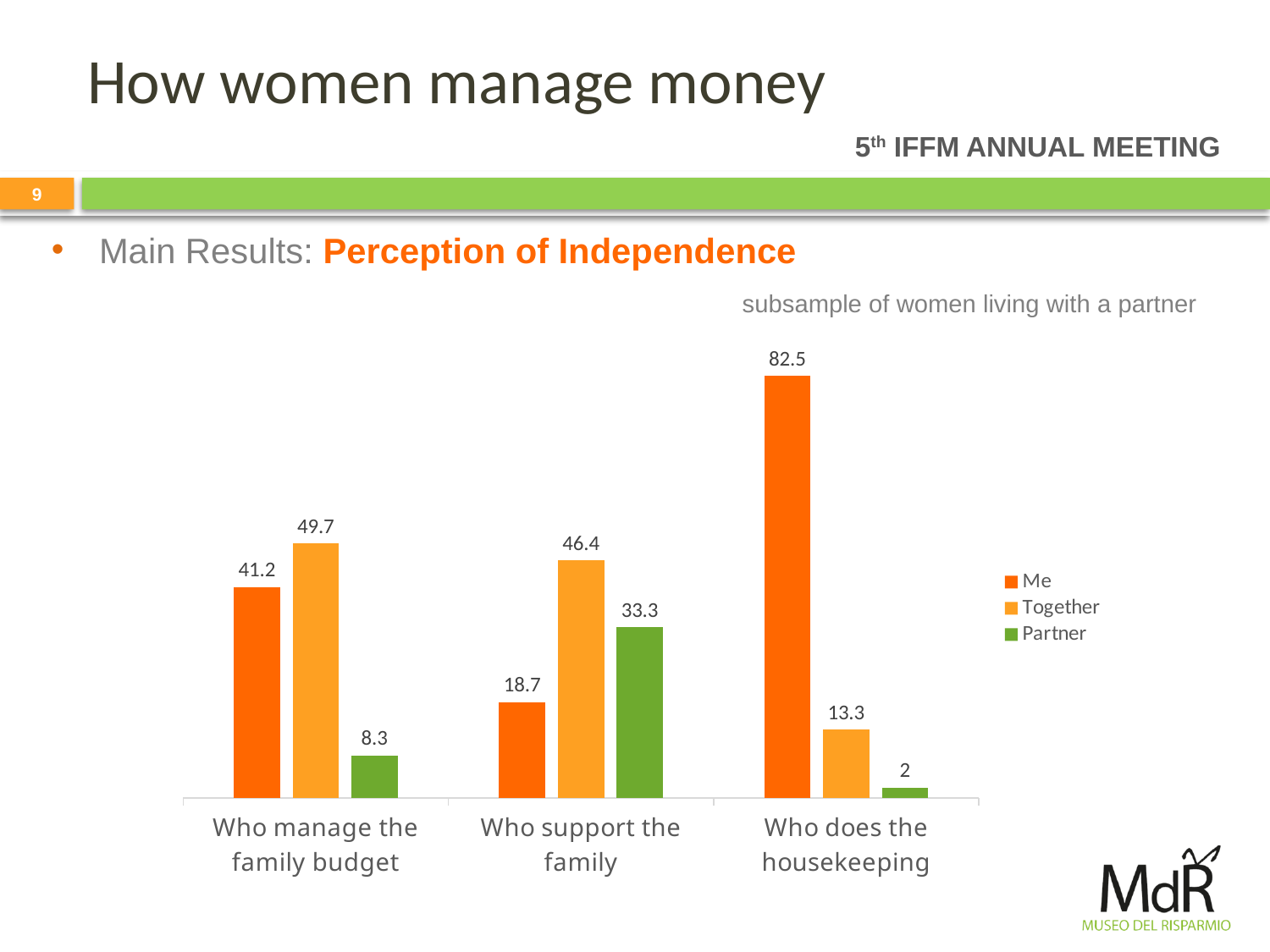
What is the value for "Partner" in the "Who support the family" category? 33.3 Which series has the lowest value in the "Who does the housekeeping" category? Partner Which colour represents the "Partner" series in the legend? Green What is the difference between the "Me" and "Partner" values in the "Who does the housekeeping" category? 80.5 How many categories are shown on the x axis? 3 Which is larger: the "Me" value for "Who manage the family budget" or the "Me" value for "Who support the family"? Who manage the family budget What is the difference between the "Together" and "Me" values in the "Who support the family" category? 27.7 What is the value for "Together" in the "Who manage the family budget" category? 49.7 What kind of chart is shown on the slide? Bar chart What is the value for "Me" in the "Who does the housekeeping" category? 82.5 Which series has the highest value in the "Who manage the family budget" category? Together How many series does the legend list? 3